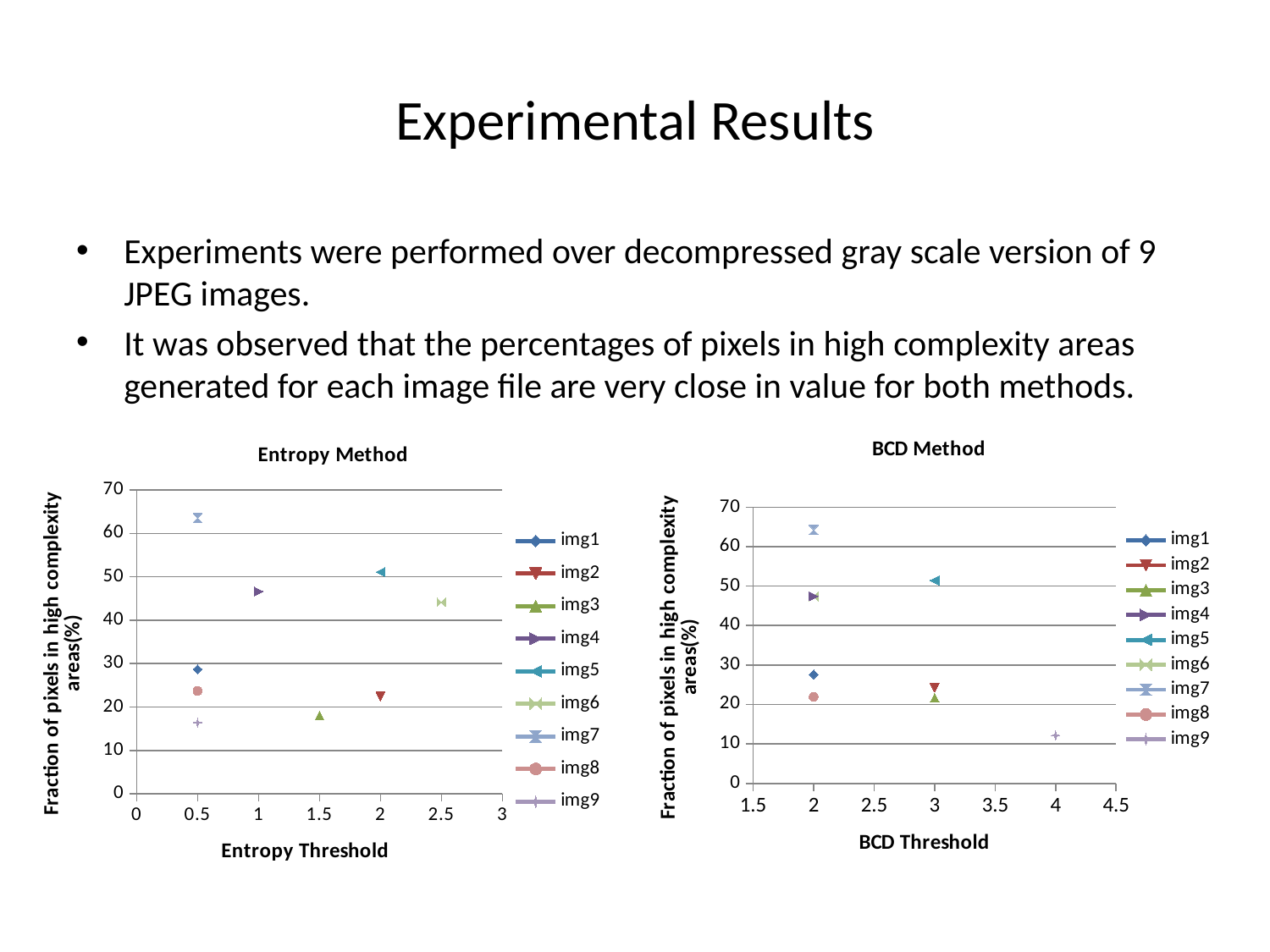
In the BCD Method chart, which image has the lowest fraction of pixels in high complexity areas? img9 In the BCD Method chart, which image has the highest fraction of pixels in high complexity areas? img7 In the BCD Method chart, how many series does the legend list? 9 In the Entropy Method chart, is the value for img1 greater or less than 30? less In the BCD Method chart, is the value for img9 greater or less than 10? greater What is the x-axis title of the BCD Method chart? BCD Threshold In the Entropy Method chart, is the value for img7 greater or less than 60? greater What kind of chart is the Entropy Method chart? scatter chart In the Entropy Method chart, which image has the highest fraction of pixels in high complexity areas? img7 In the Entropy Method chart, how many series does the legend list? 9 In the BCD Method chart, which is larger, the value for img5 or the value for img1? img5